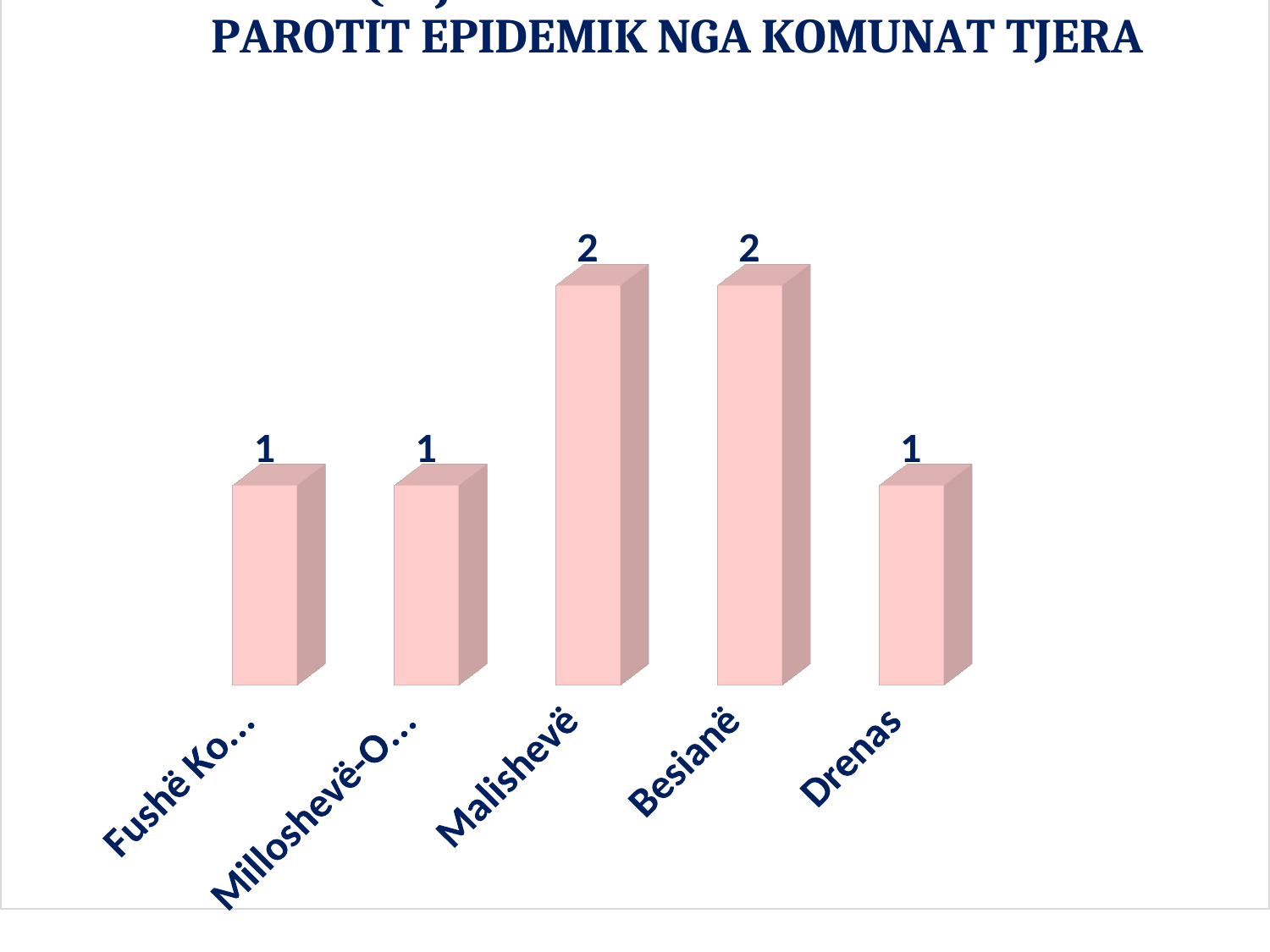
What is the value for Besianë? 2 What kind of chart is shown on the slide? bar chart What is the difference between the value for Besianë and the value for Drenas? 1 What is the value for Drenas? 1 How many categories are shown in the chart? 5 How many categories have a value of 2? 2 What colour are the bars in the chart? pink Which two categories share the highest value in the chart? Malishevë and Besianë Which is larger, the value for Malishevë or the value for Drenas? Malishevë What is the value of the leftmost bar in the chart? 1 Which is larger, the value for Besianë or the value for Drenas? Besianë What is the value for Malishevë? 2